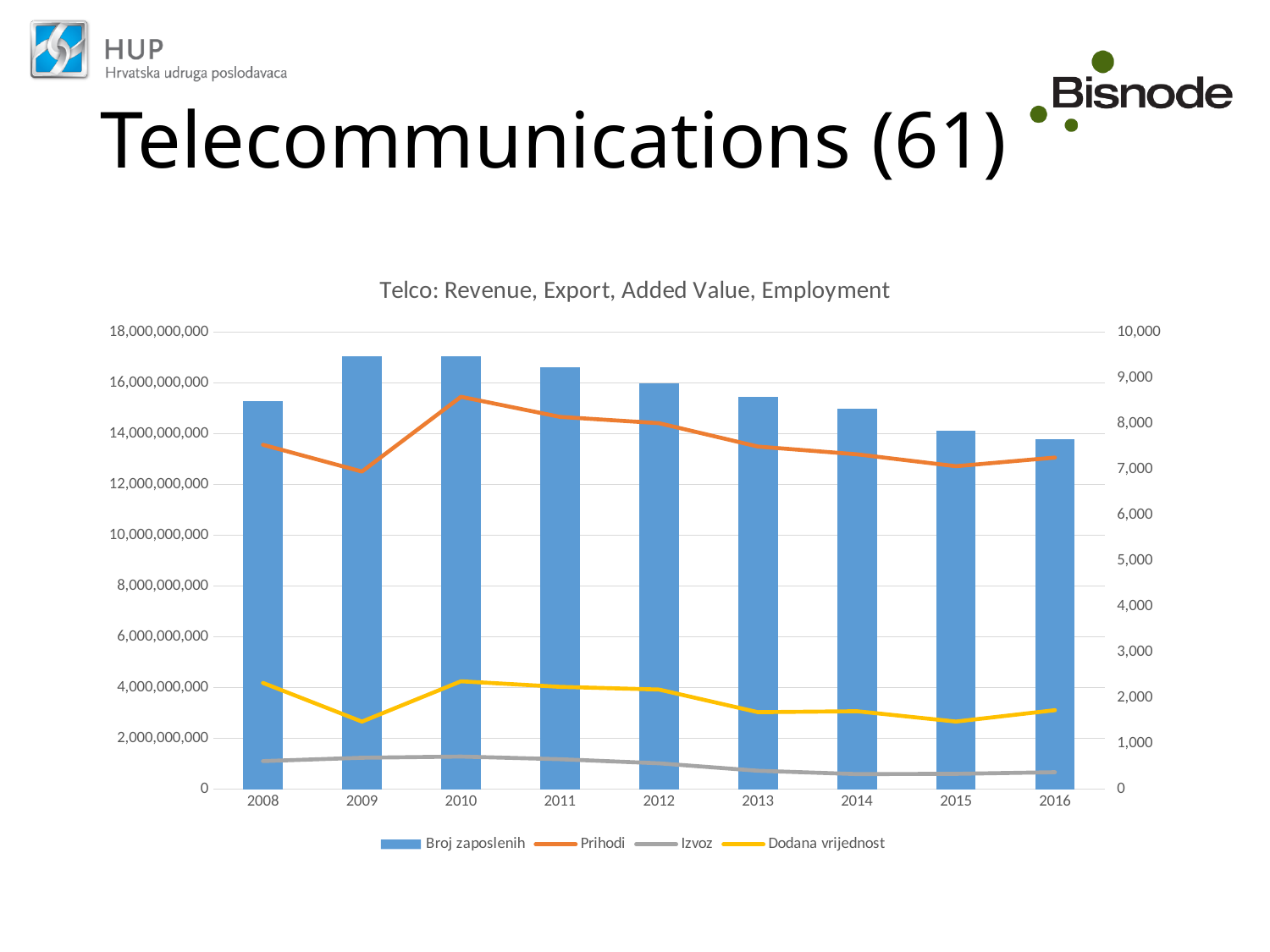
Is the Izvoz value for 2016 greater or less than 2,000,000,000? less How many years are shown on the x axis of the chart? 9 Is the Prihodi value for 2009 greater or less than 14,000,000,000? less Is the Broj zaposlenih value for 2016 greater or less than 8,000 on the right axis? less Which series is drawn as bars in the chart? Broj zaposlenih How many series does the chart legend list? 4 What kind of chart is shown on the slide? Combined bar and line chart What is the title of the chart? Telco: Revenue, Export, Added Value, Employment In which year is Prihodi highest? 2010 In which year is the Broj zaposlenih bar lowest? 2016 Which is larger, the Broj zaposlenih bar for 2009 or for 2016? 2009